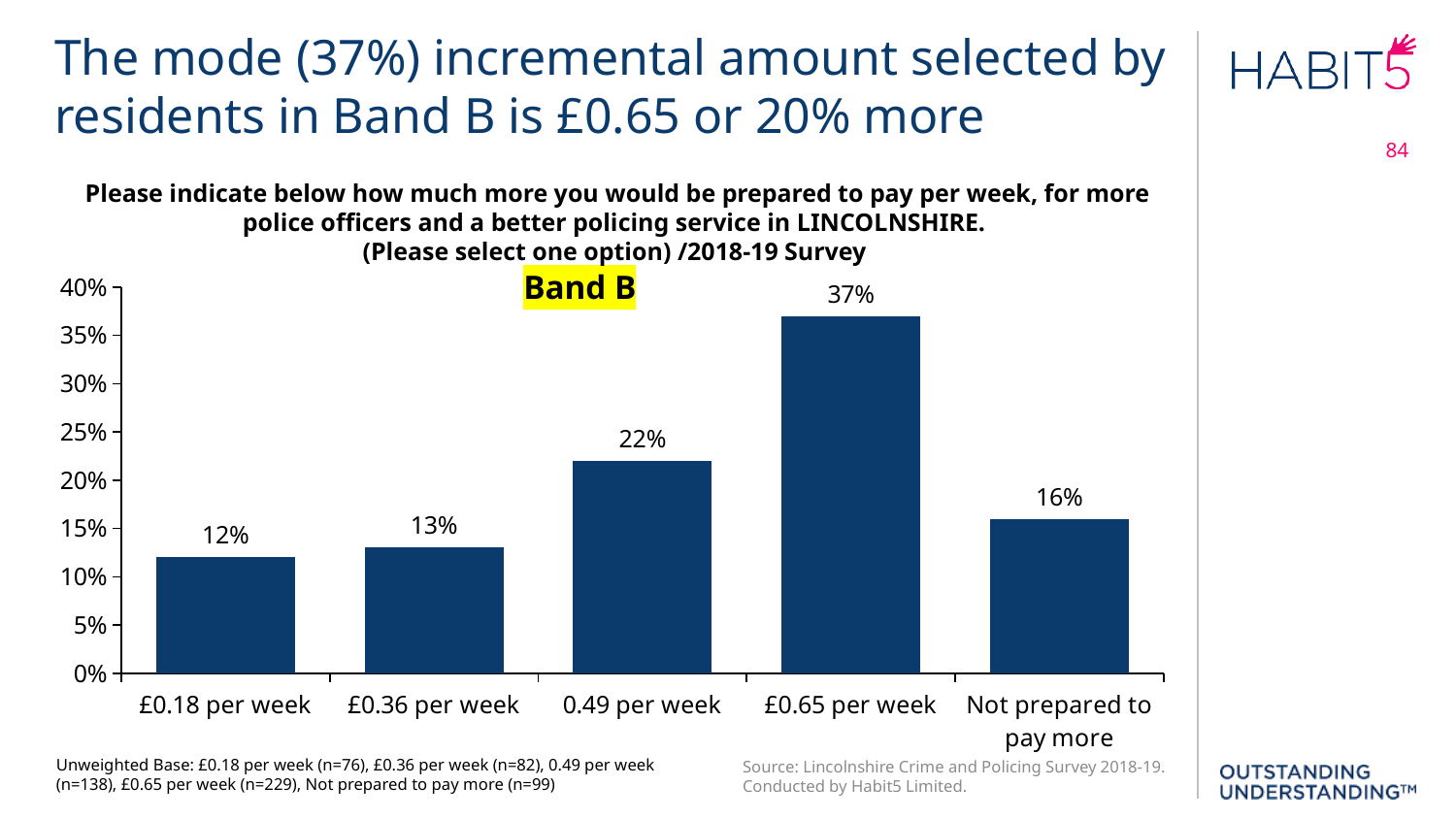
Which option has the lowest percentage in the Band B chart? £0.18 per week What percentage of Band B residents were not prepared to pay more? 16% Which is larger: the percentage for 0.49 per week or for Not prepared to pay more? 0.49 per week What is the difference in percentage points between £0.36 per week and £0.18 per week? 1 What is the difference in percentage points between £0.65 per week and 0.49 per week? 15 What type of chart is shown on the slide? bar chart Is the value for £0.36 per week greater or less than 15%? less What percentage of Band B residents selected £0.65 per week? 37% Which option has the highest percentage in the Band B chart? £0.65 per week How many response options are shown on the x axis of the chart? 5 What is the highlighted label shown above the chart? Band B What percentage of Band B residents selected £0.18 per week? 12%